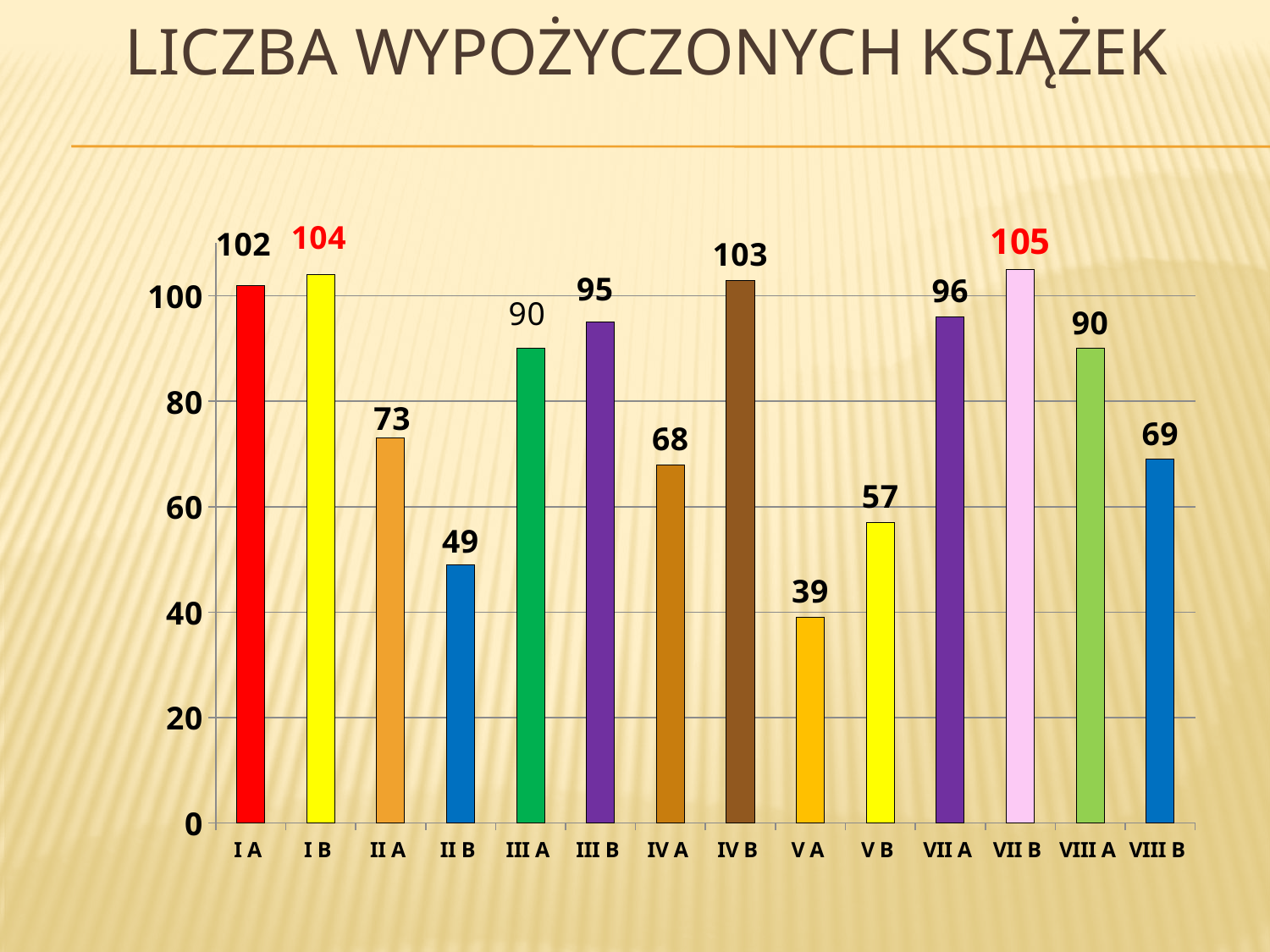
What kind of chart is shown on the slide? bar chart Which is larger, the value for III B or the value for VII A? VII A Which two data labels are printed in red? 104 and 105 How many classes are shown on the x axis? 14 What is the difference between the values for I B and II B? 55 What is the title of the chart? LICZBA WYPOŻYCZONYCH KSIĄŻEK What is the value for class IV B? 103 Which class has the highest number of borrowed books? VII B What is the value for class V B? 57 Is the value for II A greater or less than 80? less Which class has the lowest number of borrowed books? V A What is the value for class I A? 102